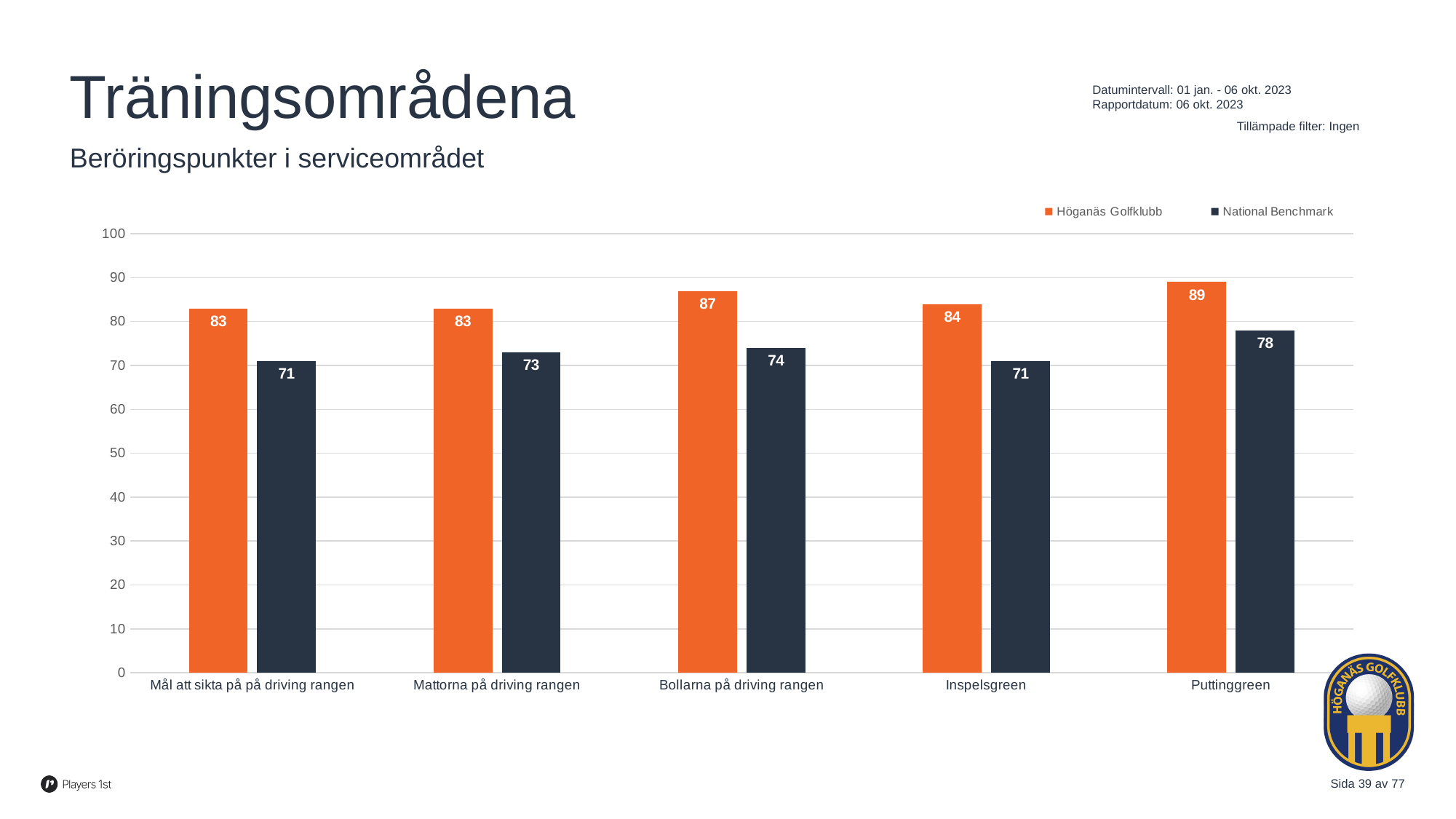
Which category has the highest Höganäs Golfklubb value? Puttinggreen How many categories are shown on the x axis? 5 How many series does the legend list? 2 What is the difference between the Höganäs Golfklubb and National Benchmark values for Puttinggreen? 11 What is the Höganäs Golfklubb value for Puttinggreen? 89 What is the Höganäs Golfklubb value for Inspelsgreen? 84 Which category has the highest National Benchmark value? Puttinggreen What is the National Benchmark value for Bollarna på driving rangen? 74 Which is larger for Mattorna på driving rangen: the Höganäs Golfklubb value or the National Benchmark value? Höganäs Golfklubb Which category has the lowest Höganäs Golfklubb value? Mål att sikta på på driving rangen and Mattorna på driving rangen (both 83) What kind of chart is shown on the slide? Bar chart What is the difference between the Höganäs Golfklubb and National Benchmark values for Inspelsgreen? 13